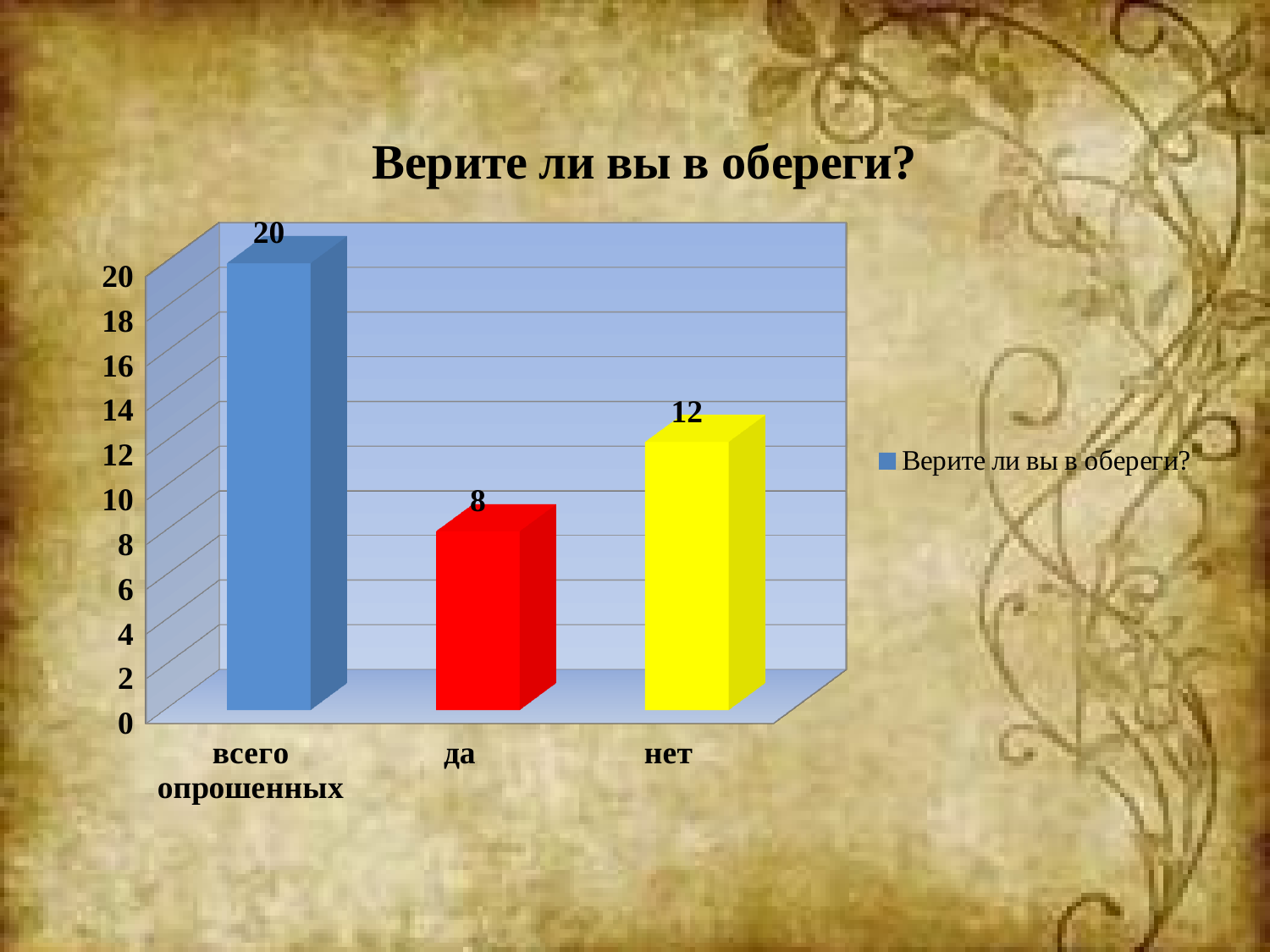
What is the value for "да"? 8 What is the value for "всего опрошенных"? 20 Which is larger, the value for "да" or the value for "нет"? нет How many series does the legend list? 1 Which category has the highest value? всего опрошенных How many categories are shown on the x axis? 3 What is the difference between the values for "нет" and "да"? 4 Is the value for "да" greater or less than 10? less What kind of chart is shown on the slide? bar chart What is the value for "нет"? 12 Which category has the lowest value? да What is the title of the chart? Верите ли вы в обереги?